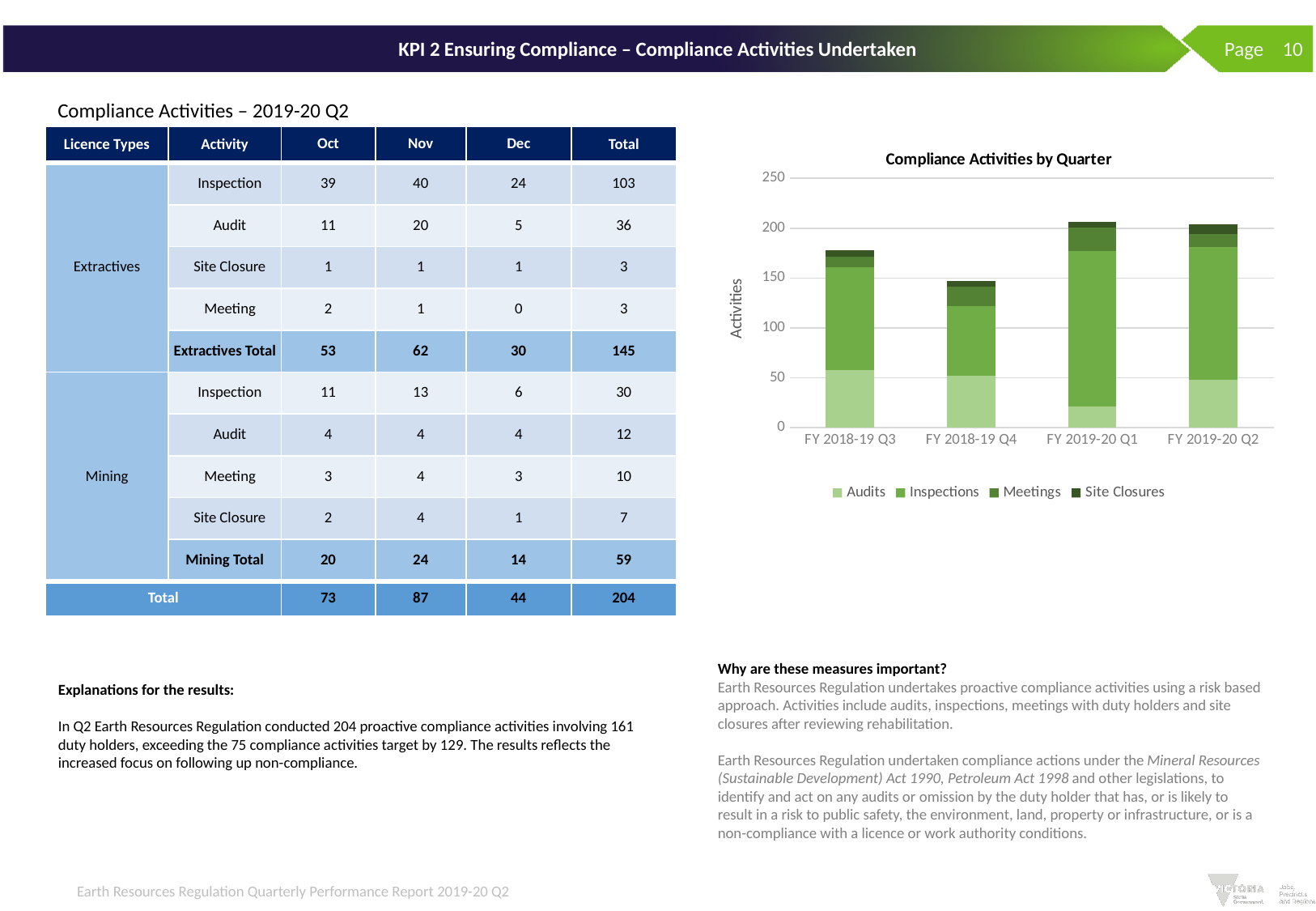
Is the Audits value for FY 2018-19 Q3 greater or less than 50? greater What is the title of the chart? Compliance Activities by Quarter How many series does the chart legend list? 4 Which quarter has the lowest total stacked bar in the chart? FY 2018-19 Q4 Is the total stacked bar for FY 2018-19 Q3 greater or less than 150? greater Which series is listed first in the chart legend? Audits Which quarter has the larger total stacked bar, FY 2018-19 Q3 or FY 2018-19 Q4? FY 2018-19 Q3 What kind of chart is shown on the slide? Stacked bar chart Is the Audits value for FY 2019-20 Q1 greater or less than 50? less How many quarters are shown on the x axis of the chart? 4 Which quarter has the larger Audits segment, FY 2018-19 Q3 or FY 2019-20 Q1? FY 2018-19 Q3